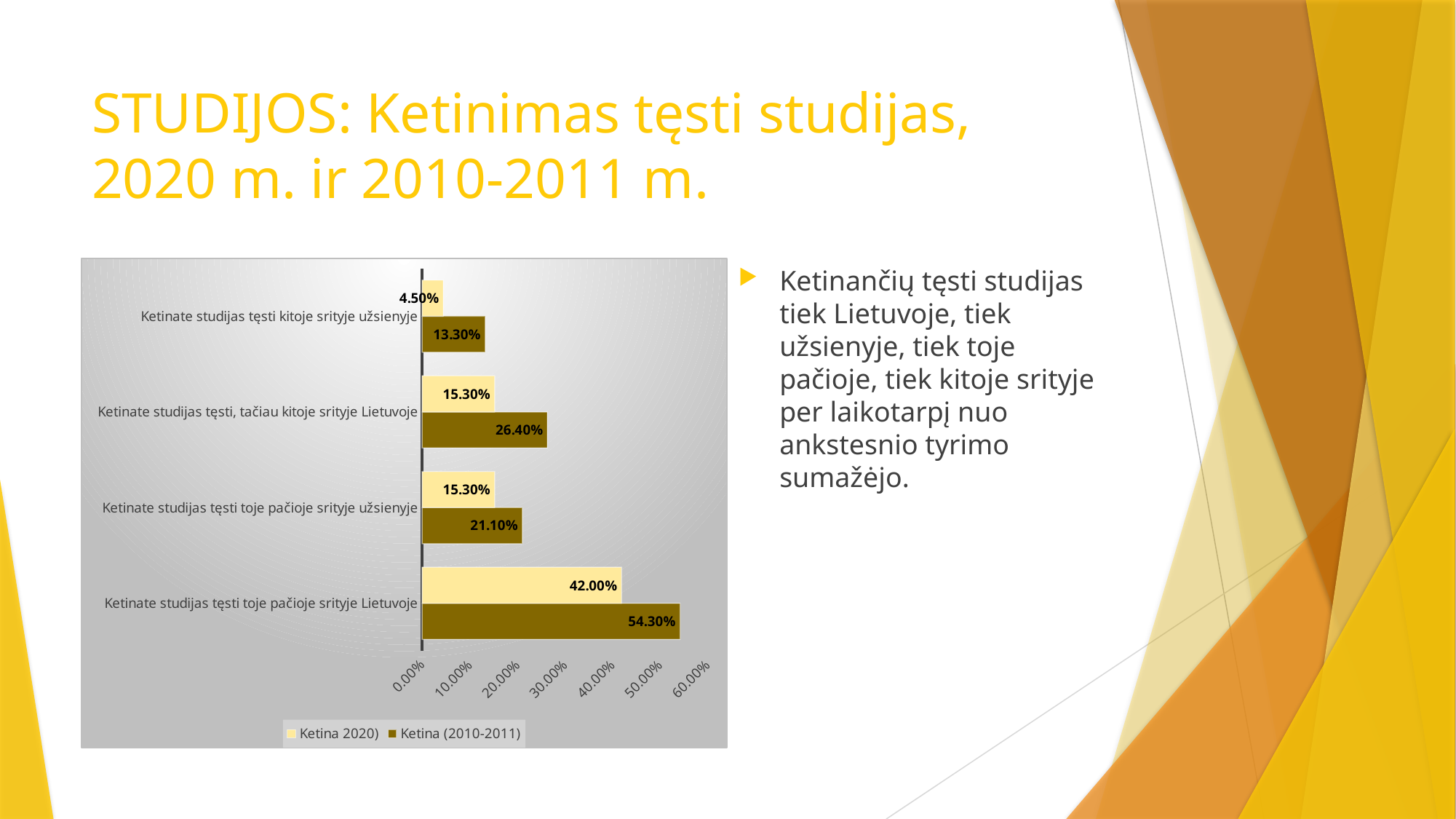
How many series does the chart legend list? 2 What is the difference between the 'Ketina (2010-2011)' and 'Ketina 2020)' values for 'Ketinate studijas tęsti toje pačioje srityje Lietuvoje'? 12.30% Which legend entry is shown with the dark brown colour? Ketina (2010-2011) What is the value for 'Ketinate studijas tęsti toje pačioje srityje Lietuvoje' in the 'Ketina (2010-2011)' series? 54.30% What is the value for 'Ketinate studijas tęsti kitoje srityje užsienyje' in the 'Ketina 2020)' series? 4.50% How many categories are shown on the chart? 4 Which category has the lowest value in the 'Ketina 2020)' series? Ketinate studijas tęsti kitoje srityje užsienyje What kind of chart is shown on the slide? bar chart What is the value for 'Ketinate studijas tęsti toje pačioje srityje Lietuvoje' in the 'Ketina 2020)' series? 42.00% What is the value for 'Ketinate studijas tęsti, tačiau kitoje srityje Lietuvoje' in the 'Ketina (2010-2011)' series? 26.40% Which category has the highest value in the 'Ketina (2010-2011)' series? Ketinate studijas tęsti toje pačioje srityje Lietuvoje For 'Ketinate studijas tęsti toje pačioje srityje užsienyje', which series has the larger value, 'Ketina 2020)' or 'Ketina (2010-2011)'? Ketina (2010-2011)